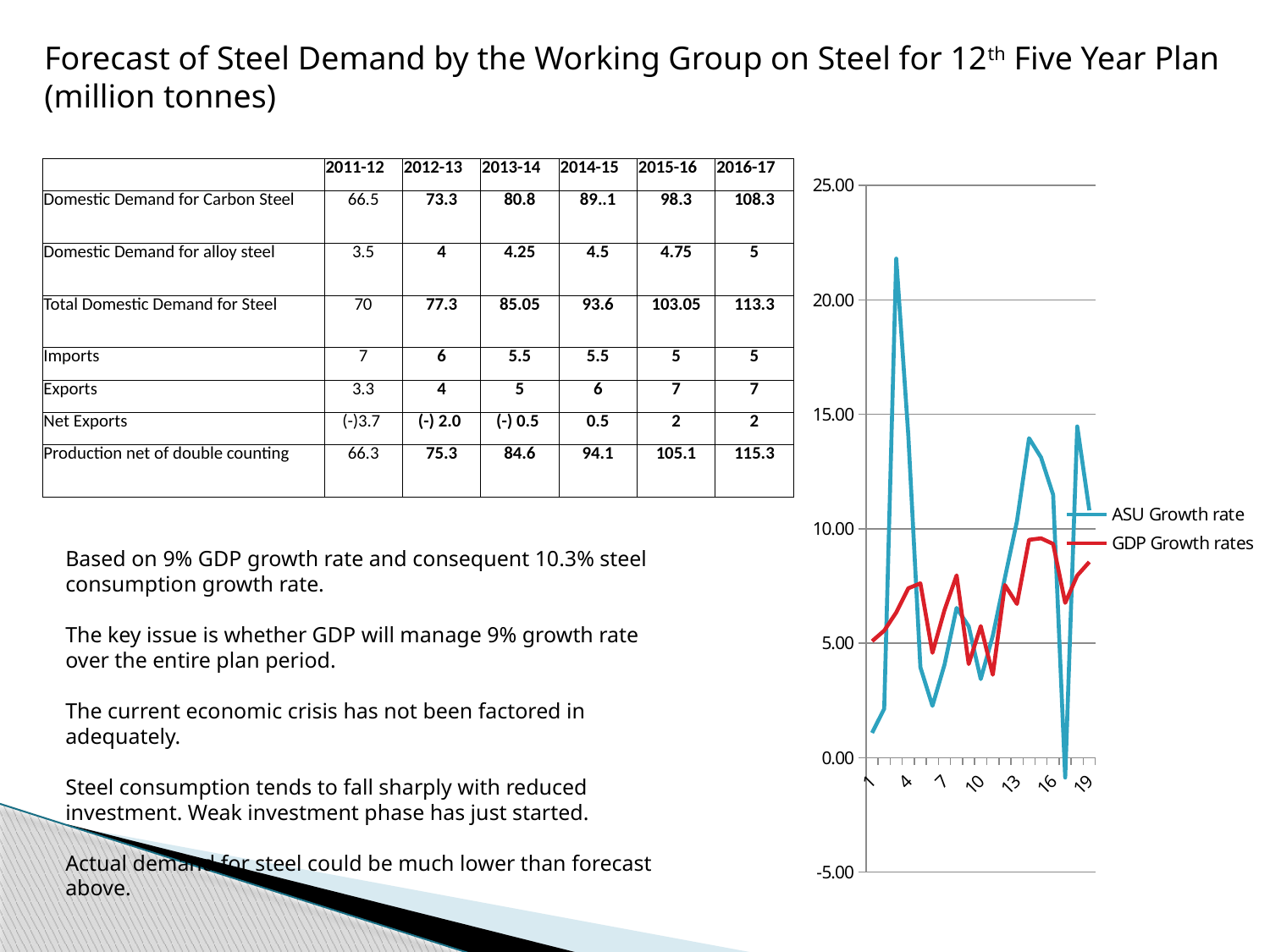
In the line chart, which series reaches the lowest value anywhere on the chart? ASU Growth rate In the line chart, is the value of the ASU Growth rate series at point 1 greater or less than 5.00? less What is the highest value labelled on the y axis of the line chart? 25.00 How many series does the legend of the line chart list? 2 In the line chart, which series reaches the highest value anywhere on the chart? ASU Growth rate What kind of chart is shown on the right side of the slide? line chart In the line chart, at point 3 on the x axis, which series has the larger value, ASU Growth rate or GDP Growth rates? ASU Growth rate In the line chart, is the lowest value of the ASU Growth rate series greater or less than 0.00? less In the line chart, which colour is used for the GDP Growth rates series? red What are the two series named in the legend of the line chart? ASU Growth rate and GDP Growth rates In the line chart, is the highest value of the ASU Growth rate series greater or less than 20.00? greater